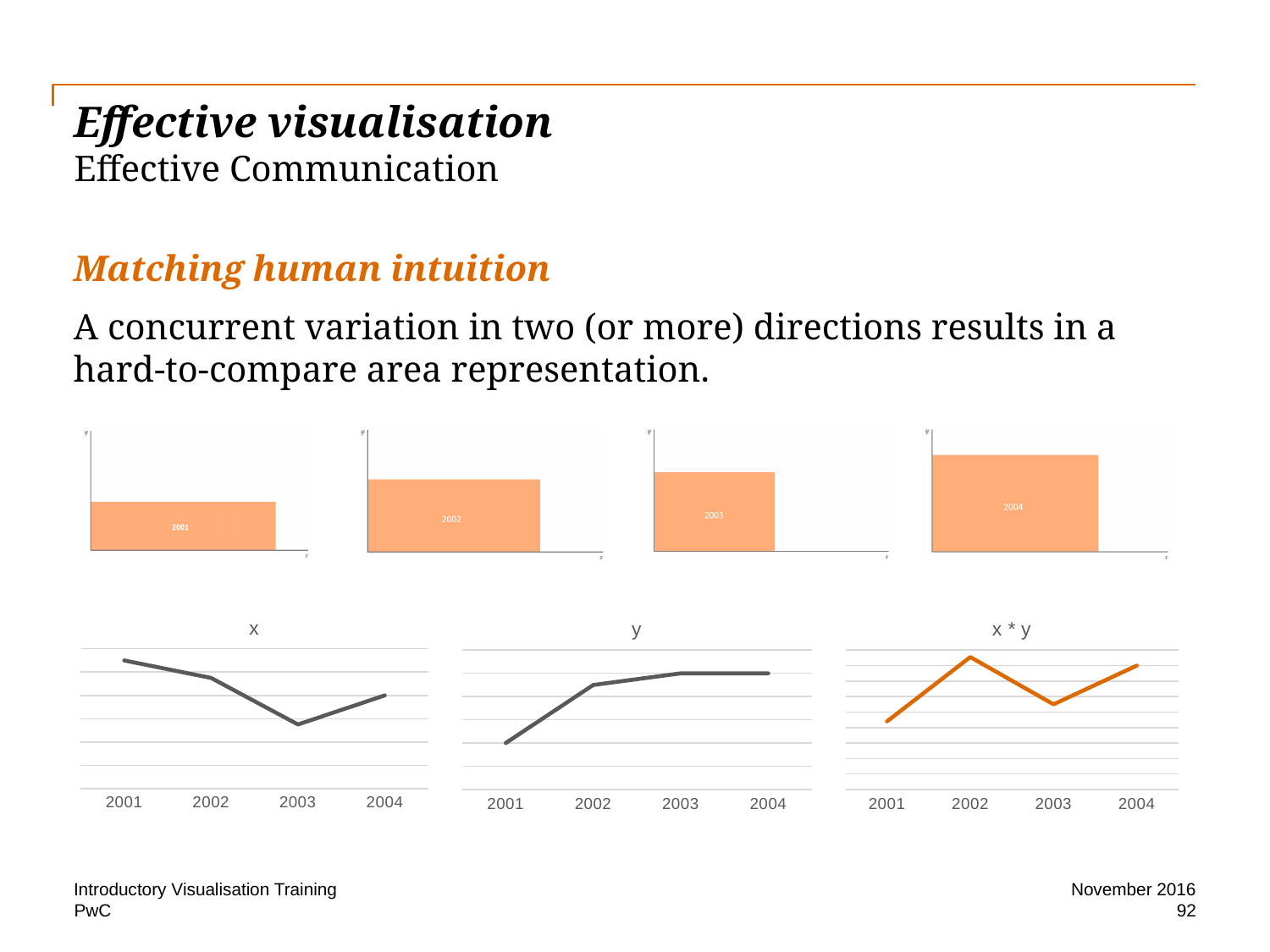
How many data points are plotted in the chart titled "x * y"? 4 In the chart titled "x", which year has the lowest value? 2003 In the chart titled "x", which year has the highest value? 2001 In the chart titled "y", which year has the lowest value? 2001 In the chart titled "x", which is larger, the value for 2002 or the value for 2004? 2002 In the chart titled "y", do the values rise or fall from 2001 to 2002? rise What are the titles of the three line charts on the slide, from left to right? x, y, x * y In the chart titled "x * y", which is larger, the value for 2003 or the value for 2004? 2004 What kind of chart is the chart titled "x"? line chart In the chart titled "x", do the values rise or fall from 2001 to 2003? fall In the chart titled "x * y", which year has the lowest value? 2001 In the chart titled "x * y", which year has the highest value? 2002